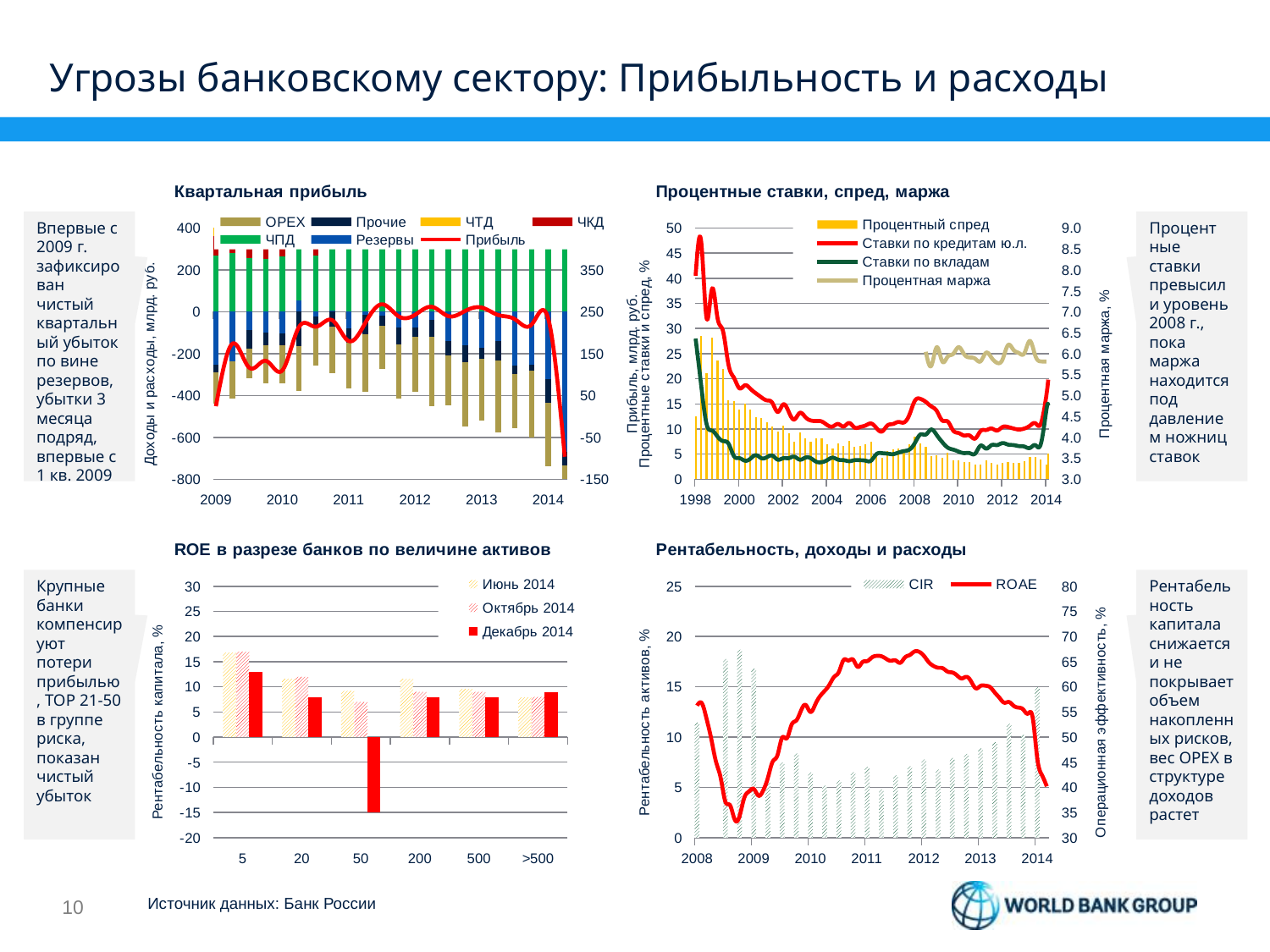
How many categories are shown on the x axis of the 'ROE в разрезе банков по величине активов' chart? 6 How many series does the legend of the 'Рентабельность, доходы и расходы' chart list? 2 What is the title of the chart in the top-right of the slide? Процентные ставки, спред, маржа How many series does the legend of the 'Квартальная прибыль' chart list? 7 What type of chart is the 'ROE в разрезе банков по величине активов' chart? bar chart In the 'ROE в разрезе банков по величине активов' chart, which is larger for category 20: Июнь 2014 or Декабрь 2014? Июнь 2014 In the 'ROE в разрезе банков по величине активов' chart, which category has the lowest value for Декабрь 2014? 50 How many series does the legend of the 'Процентные ставки, спред, маржа' chart list? 4 In the 'ROE в разрезе банков по величине активов' chart, is the Июнь 2014 value for category 5 greater or less than 15? greater In the 'Рентабельность, доходы и расходы' chart, does the ROAE line rise or fall from 2012 to 2014? fall In the 'ROE в разрезе банков по величине активов' chart, is the Декабрь 2014 value for category 50 greater or less than 0? less In the 'ROE в разрезе банков по величине активов' chart, which category has the highest value for Декабрь 2014? 5